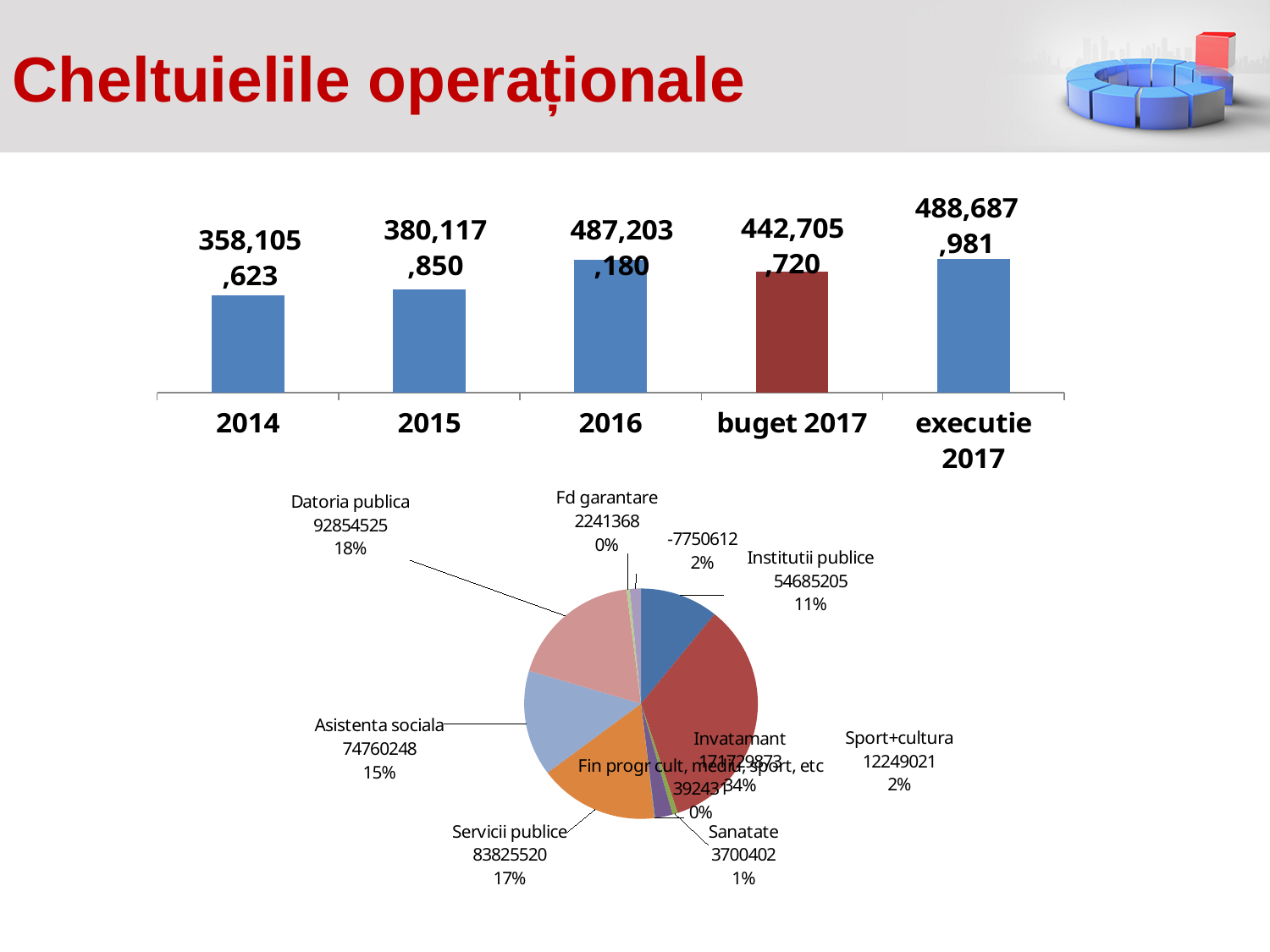
In the top bar chart, which category has the highest value? executie 2017 How many bars are in the top bar chart? 5 In the bottom pie chart, what is the value for Servicii publice? 83825520 In the top bar chart, what is the value for 2014? 358,105,623 In the top bar chart, what is the value for buget 2017? 442,705,720 In the top bar chart, what is the value for executie 2017? 488,687,981 In the top bar chart, which is larger, the value for 2016 or the value for buget 2017? 2016 In the top bar chart, what is the difference between the values for 2015 and 2014? 22,012,227 In the bottom pie chart, which is larger, Asistenta sociala or Institutii publice? Asistenta sociala What kind of chart is the top chart on the slide? bar chart In the bottom pie chart, what share does Datoria publica have? 18% In the top bar chart, which category has the lowest value? 2014